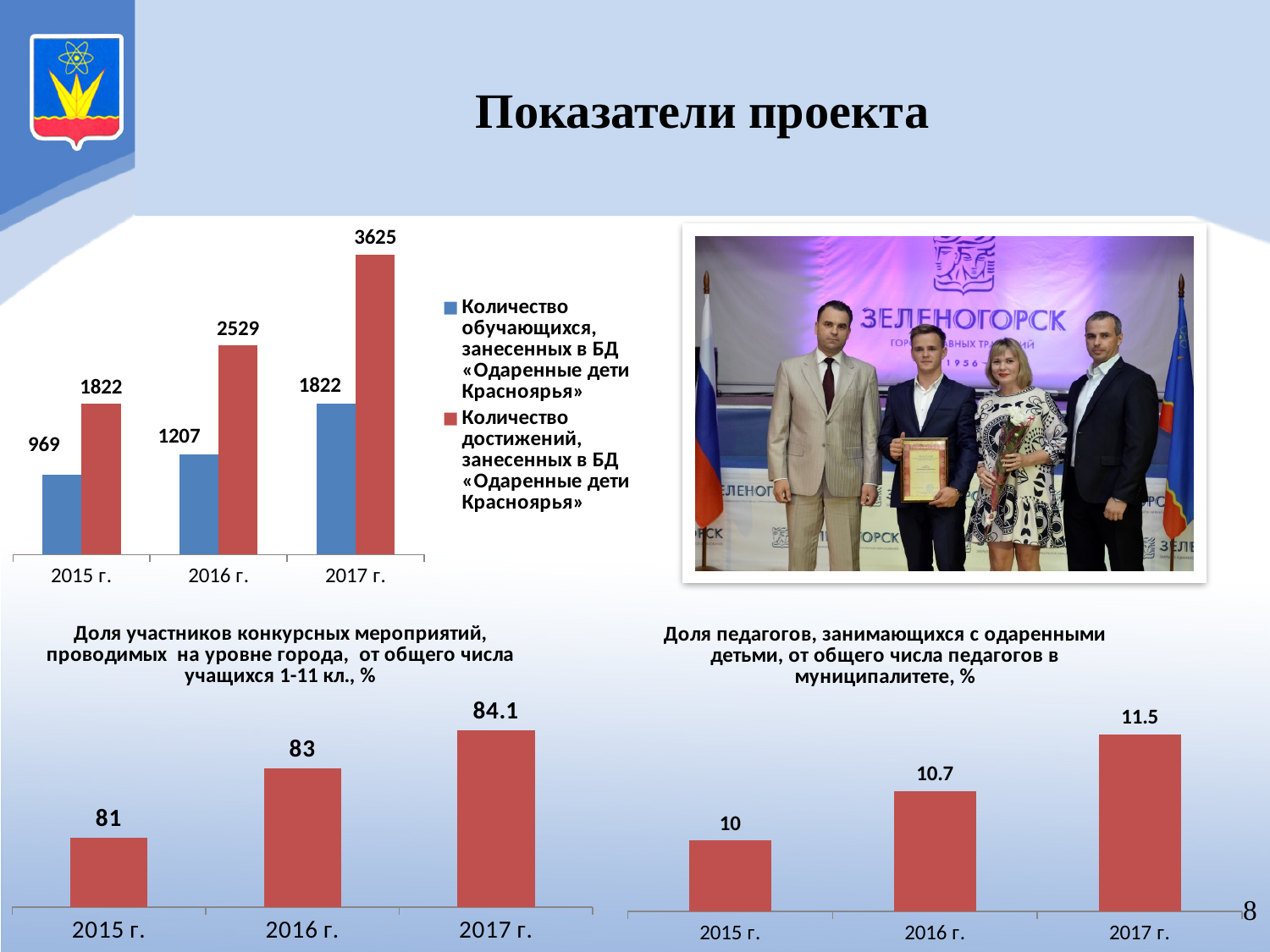
In the top-left chart, what is the difference between the number of achievements and the number of students in 2016 г.? 1322 What type of chart is the bottom-right chart 'Доля педагогов, занимающихся с одаренными детьми...'? Bar chart In the top-left chart, in which year is the number of students entered in the database highest? 2017 г. In the top-left chart, which colour represents 'Количество достижений, занесенных в БД «Одаренные дети Красноярья»'? Red In the chart 'Доля участников конкурсных мероприятий...', do the values rise or fall from 2015 г. to 2017 г.? Rise In the chart 'Доля участников конкурсных мероприятий...', what is the difference between the 2016 г. and 2015 г. values? 2 In the chart 'Доля участников конкурсных мероприятий, проводимых на уровне города, от общего числа учащихся 1-11 кл., %', what is the value for 2017 г.? 84.1 In the top-left chart, how many series does the legend list? 2 In the top-left chart, what is the value for 'Количество обучающихся, занесенных в БД «Одаренные дети Красноярья»' in 2015 г.? 969 In the top-left chart, what is the value for 'Количество достижений, занесенных в БД «Одаренные дети Красноярья»' in 2017 г.? 3625 In the chart 'Доля педагогов, занимающихся с одаренными детьми...', which year has the lowest value? 2015 г. In the chart 'Доля педагогов, занимающихся с одаренными детьми, от общего числа педагогов в муниципалитете, %', what is the value for 2016 г.? 10.7